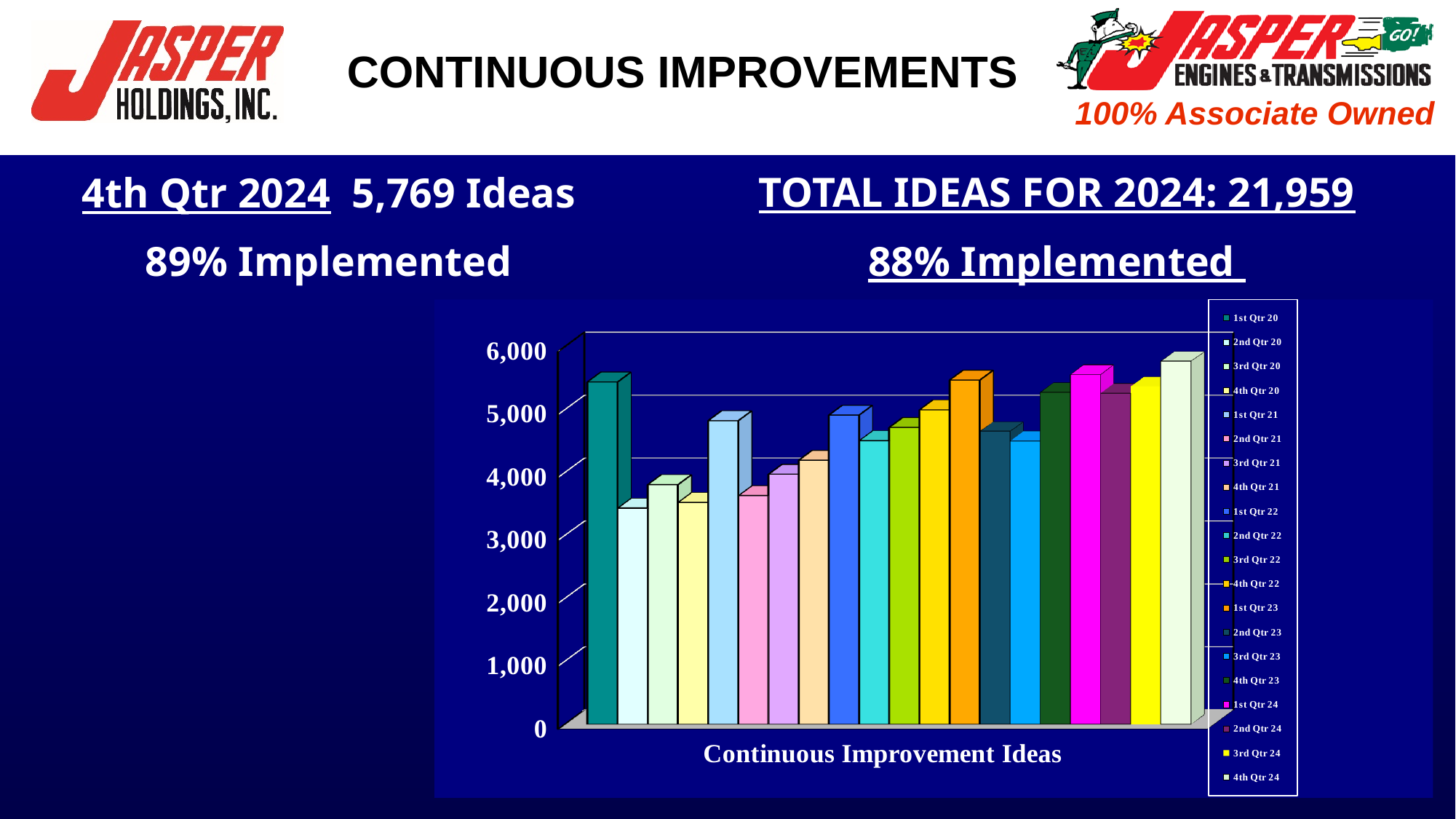
Which series has the tallest bar in the chart? 4th Qtr 24 Do the bars generally rise or fall from left to right across the chart? rise What kind of chart is shown on the slide? Bar chart Which is larger, the value for 1st Qtr 20 or the value for 2nd Qtr 20? 1st Qtr 20 What is the category label shown on the x axis of the chart? Continuous Improvement Ideas How many ideas were submitted in 4th Qtr 2024 according to the slide? 5,769 How many categories are shown on the x axis of the chart? 1 What is the first entry listed in the chart legend? 1st Qtr 20 Is the value for 1st Qtr 23 greater or less than 5,000? greater Is the value for 1st Qtr 20 greater or less than 5,000? greater Is the value for 2nd Qtr 20 greater or less than 4,000? less How many series does the chart legend list? 20